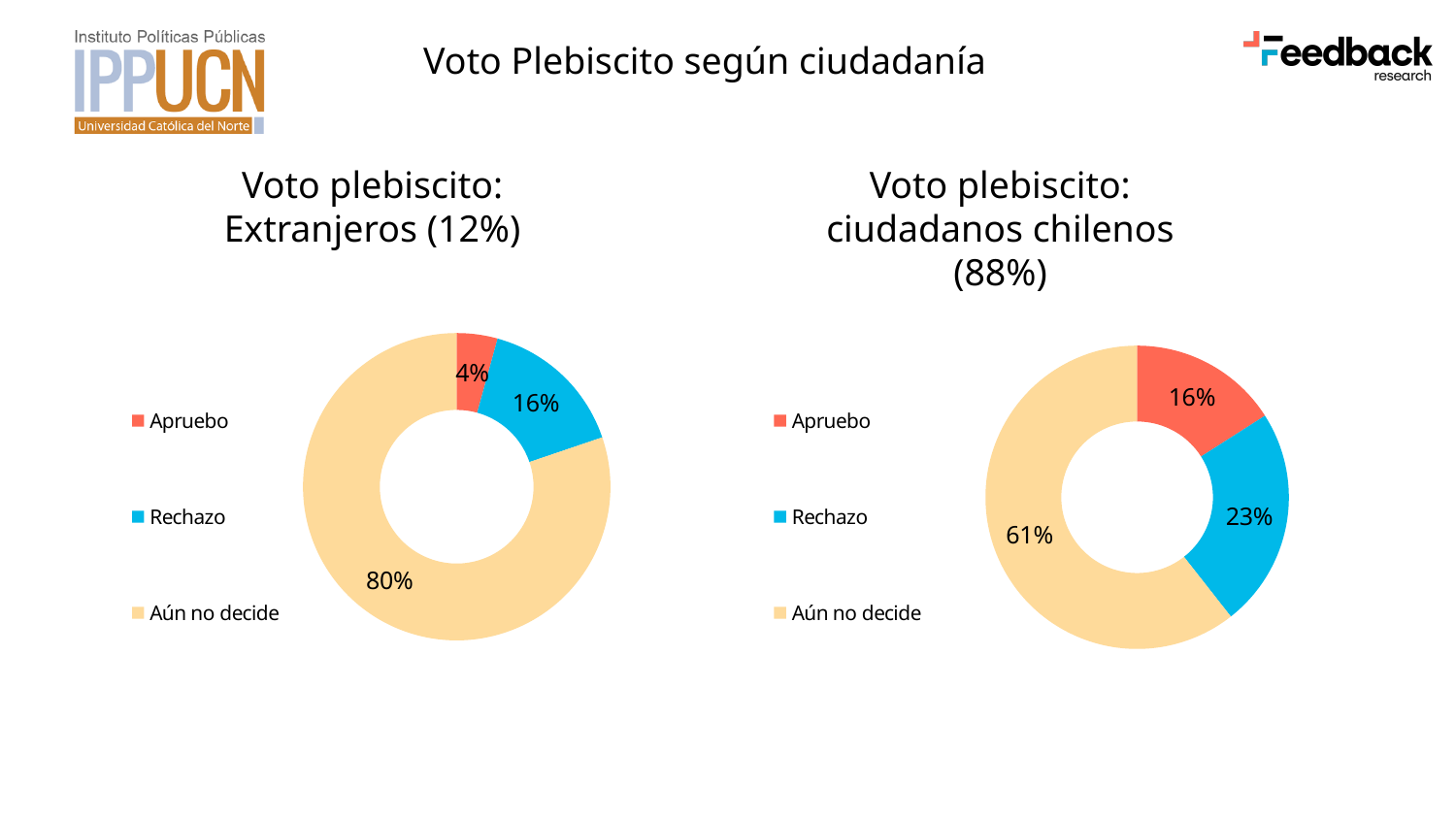
In the 'Voto plebiscito: Extranjeros (12%)' chart, which category has the smallest share? Apruebo In the 'Voto plebiscito: ciudadanos chilenos (88%)' chart, which category has the largest share? Aún no decide What kind of chart is the 'Voto plebiscito: Extranjeros (12%)' chart? Doughnut chart In the 'Voto plebiscito: ciudadanos chilenos (88%)' chart, what is the difference between Aún no decide and Rechazo? 38% In the 'Voto plebiscito: ciudadanos chilenos (88%)' chart, what is the value for Rechazo? 23% In the 'Voto plebiscito: Extranjeros (12%)' chart, what is the value for Aún no decide? 80% In the 'Voto plebiscito: Extranjeros (12%)' chart, what is the difference between Rechazo and Apruebo? 12% In the 'Voto plebiscito: Extranjeros (12%)' chart, which colour represents Rechazo? Blue In the 'Voto plebiscito: Extranjeros (12%)' chart, what is the value for Apruebo? 4% In the 'Voto plebiscito: ciudadanos chilenos (88%)' chart, what is the value for Apruebo? 16% Which is larger: Rechazo in the 'Voto plebiscito: Extranjeros (12%)' chart or Rechazo in the 'Voto plebiscito: ciudadanos chilenos (88%)' chart? ciudadanos chilenos (88%) How many categories does the 'Voto plebiscito: ciudadanos chilenos (88%)' chart show? 3